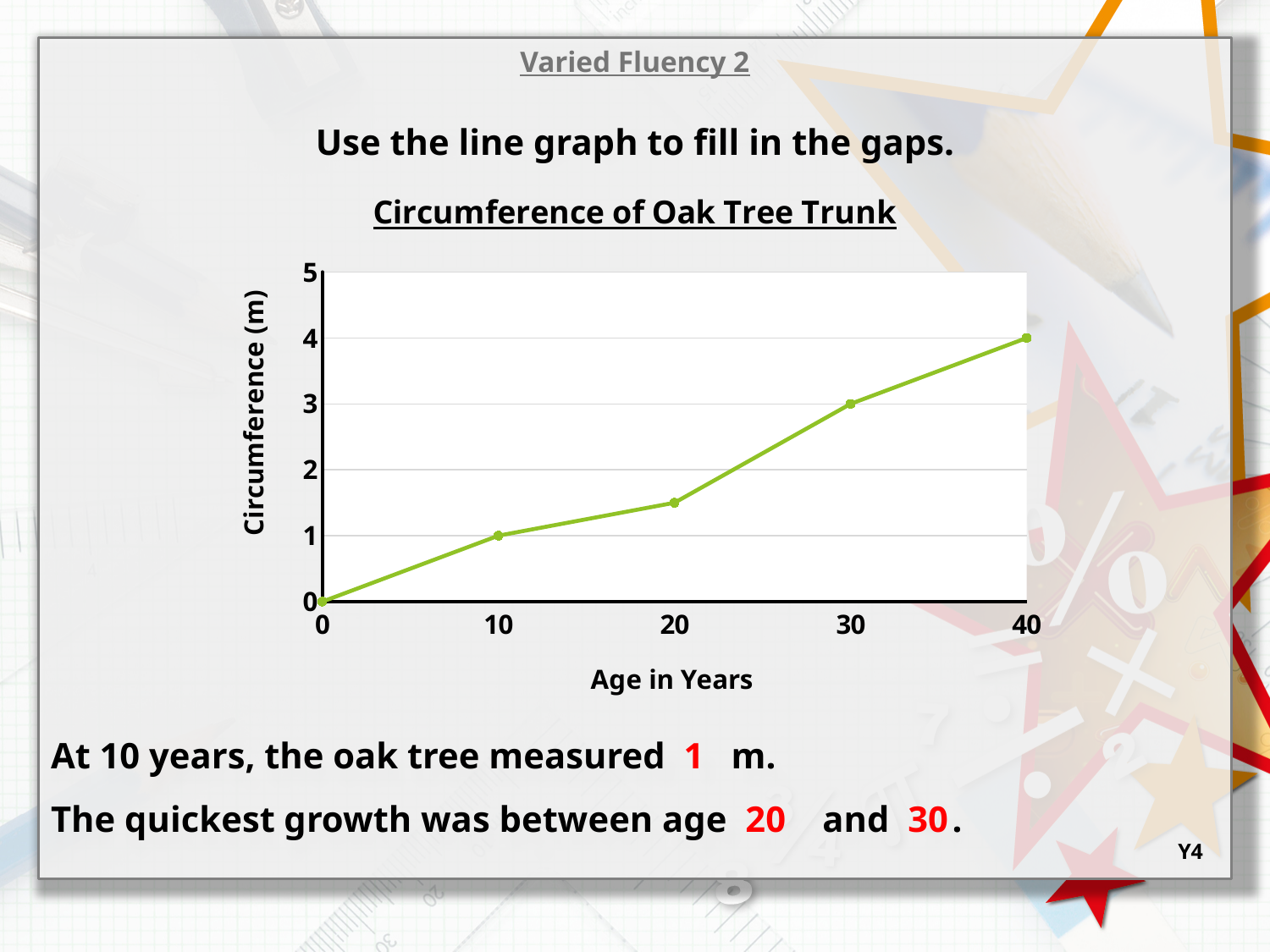
What was the circumference of the oak tree trunk at 30 years? 3 At which age is the circumference highest? 40 What was the circumference of the oak tree trunk at 10 years? 1 Is the circumference at 20 years greater or less than 2? less Does the circumference rise or fall as age increases? rise What is the difference in circumference between 40 years and 30 years? 1 What was the circumference of the oak tree trunk at age 0? 0 Is the circumference at 20 years greater or less than 1? greater What is the title of the x axis? Age in Years How many data points are plotted on the line? 5 What kind of chart is shown on the slide? line chart What was the circumference of the oak tree trunk at 40 years? 4